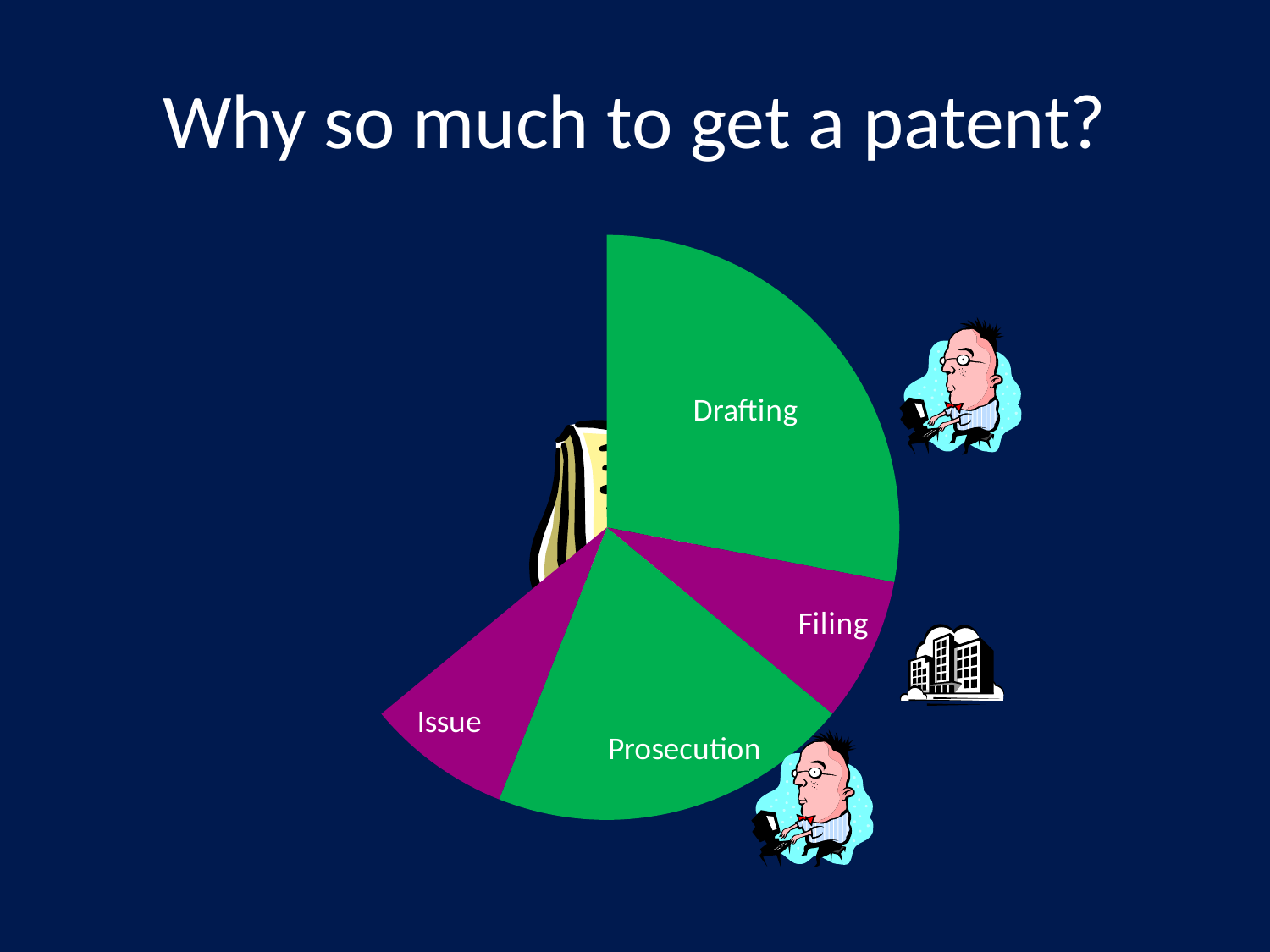
What colour are the Drafting and Prosecution slices of the pie chart? green Which slice is larger, Prosecution or Issue? Prosecution What kind of chart is shown on the slide? pie chart Which slice of the pie chart is the largest? Drafting How many slices does the pie chart have? 4 Which slice is larger, Drafting or Filing? Drafting Which slice is larger, Drafting or Prosecution? Drafting What is the title of the slide containing the pie chart? Why so much to get a patent?